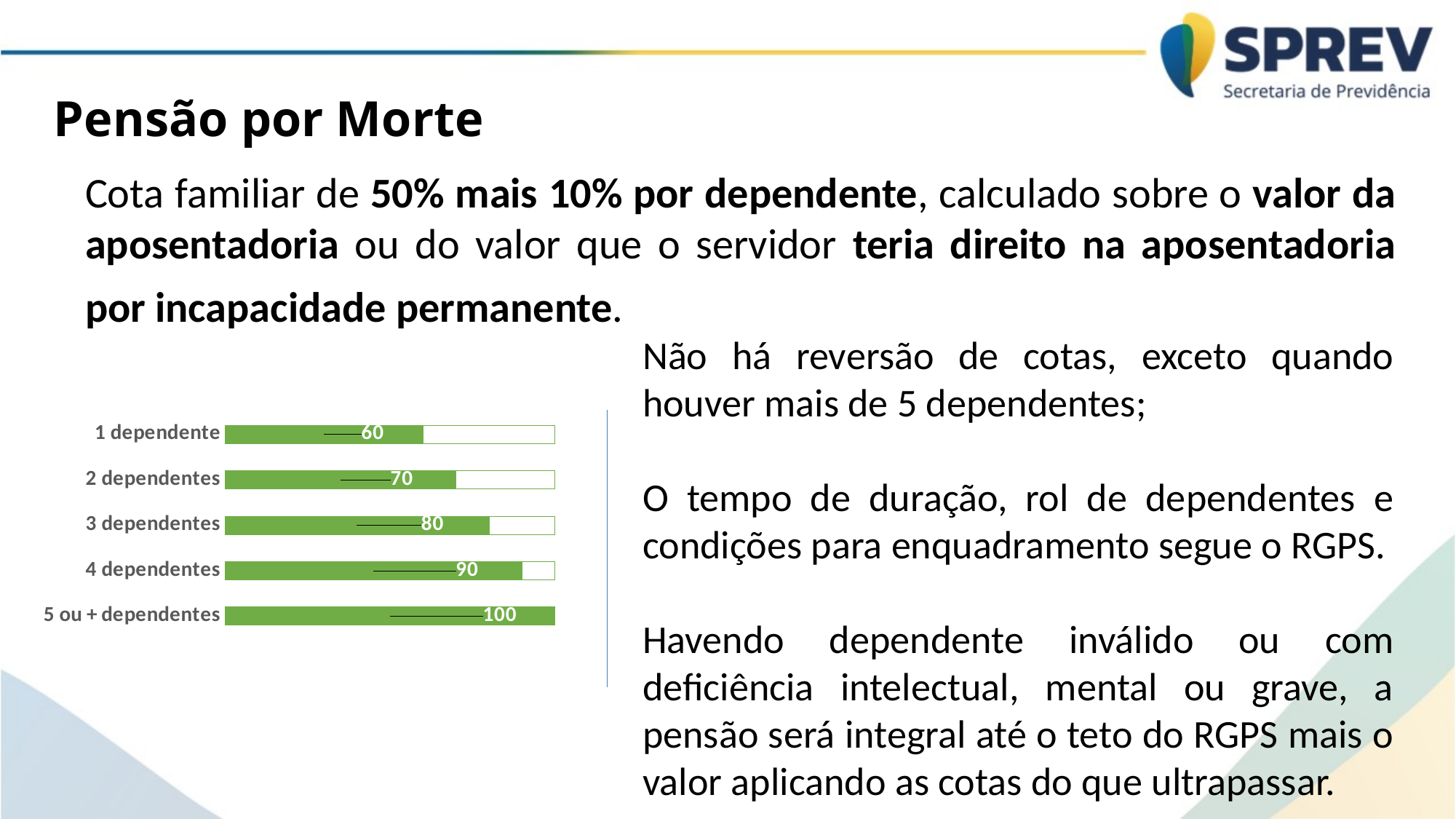
What value is shown for "3 dependentes" in the chart? 80 Which is larger, the value for "2 dependentes" or the value for "4 dependentes"? 4 dependentes Which category has the highest value in the chart? 5 ou + dependentes How many categories are shown in the chart? 5 What value is shown for "1 dependente" in the chart? 60 What value is shown for "4 dependentes" in the chart? 90 Do the values increase or decrease as the number of dependents goes from 1 to 5 or more? Increase What kind of chart is shown on the slide? Bar chart What value is shown for "5 ou + dependentes" in the chart? 100 What is the difference between the values for "5 ou + dependentes" and "1 dependente"? 40 Which category has the lowest value in the chart? 1 dependente What is the difference between the values for "2 dependentes" and "1 dependente"? 10